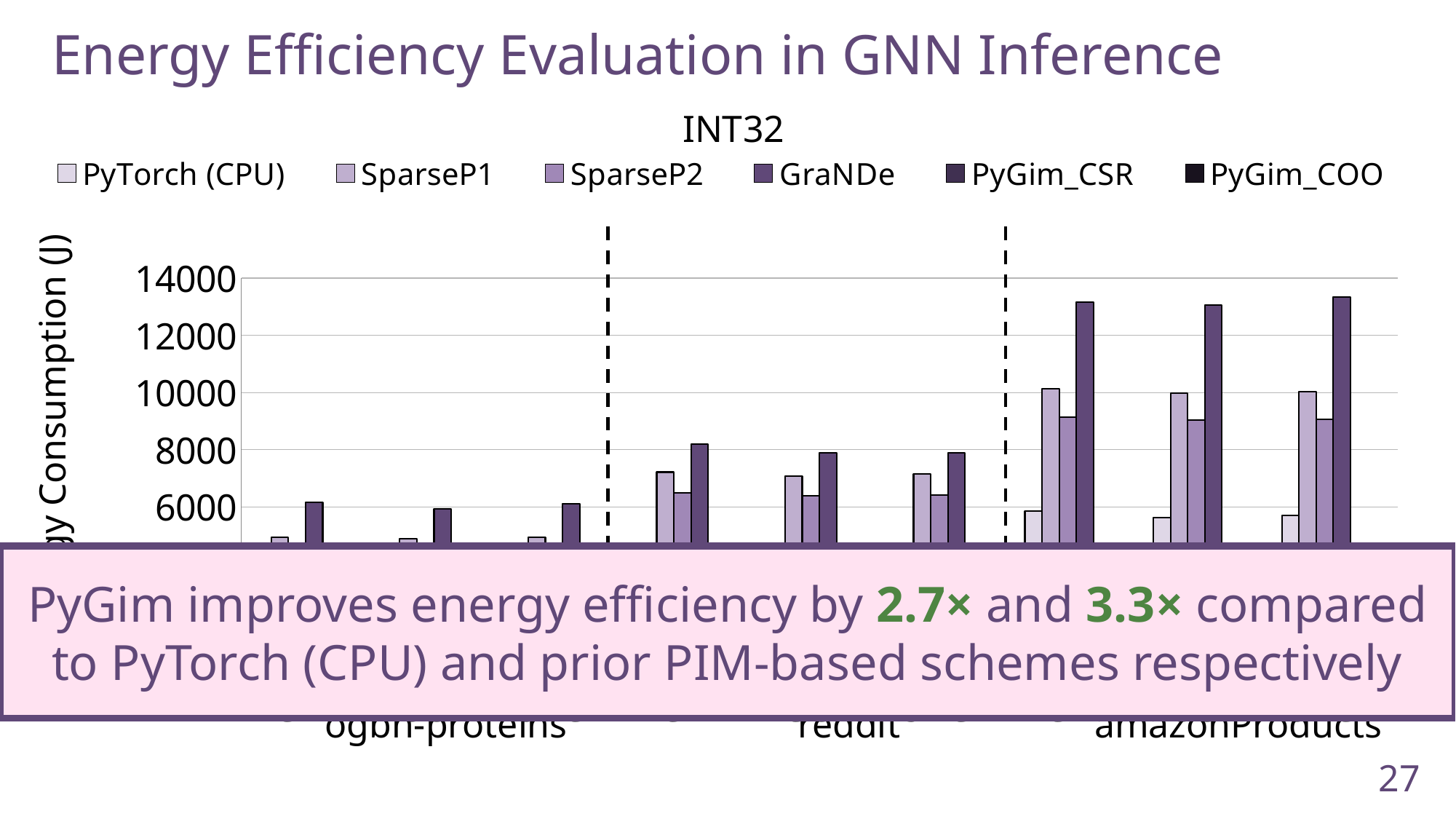
How many dataset groups are labelled on the x axis of the chart? 3 What kind of chart is shown on the slide? bar chart Are the SparseP1 values for reddit greater or less than 8000? less Are the GraNDe values for amazonProducts greater or less than 12000? greater Do the GraNDe values rise or fall going from ogbn-proteins to amazonProducts along the x axis? rise Are the SparseP2 values for amazonProducts greater or less than 10000? less In the reddit group, which is larger, the SparseP1 value or the SparseP2 value? SparseP1 Which series is listed first in the chart's legend? PyTorch (CPU) What is the title shown above the chart's legend? INT32 How many series does the chart's legend list? 6 Which dataset group contains the highest energy consumption bars in the chart? amazonProducts Which series has the tallest bars in the amazonProducts group? GraNDe